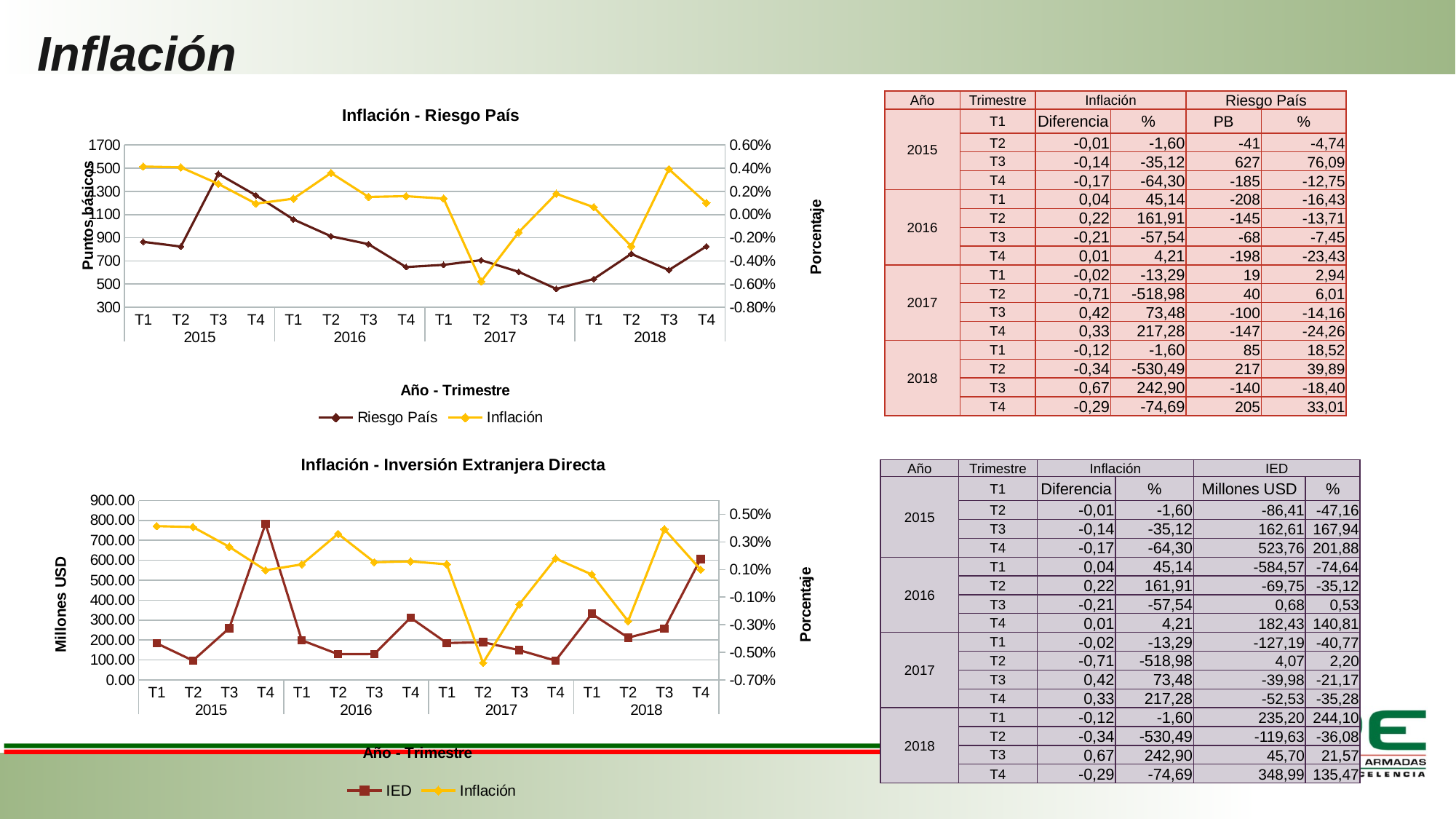
In the 'Inflación - Riesgo País' chart, in which quarter is the Riesgo País series lowest? T4 2017 In the 'Inflación - Inversión Extranjera Directa' chart, is the IED value for T4 2018 greater or less than 500.00? greater In the 'Inflación - Inversión Extranjera Directa' chart, in which quarter is the IED series highest? T4 2015 In the 'Inflación - Riesgo País' chart, in which quarter is the Riesgo País series highest? T3 2015 How many series does the legend of the 'Inflación - Riesgo País' chart list? 2 In the 'Inflación - Riesgo País' chart, is the Riesgo País value for T3 2015 greater or less than 1300? greater In the 'Inflación - Riesgo País' chart, which is larger for Riesgo País: T3 2015 or T1 2016? T3 2015 In the 'Inflación - Riesgo País' chart, is the Inflación value for T2 2017 greater or less than -0.40%? less What is the title of the left vertical axis of the 'Inflación - Inversión Extranjera Directa' chart? Millones USD What kind of chart is the 'Inflación - Riesgo País' chart? line chart In the 'Inflación - Inversión Extranjera Directa' chart, does the IED series rise or fall from T2 2018 to T4 2018? rise How many quarterly points are plotted for each series in the 'Inflación - Riesgo País' chart? 16